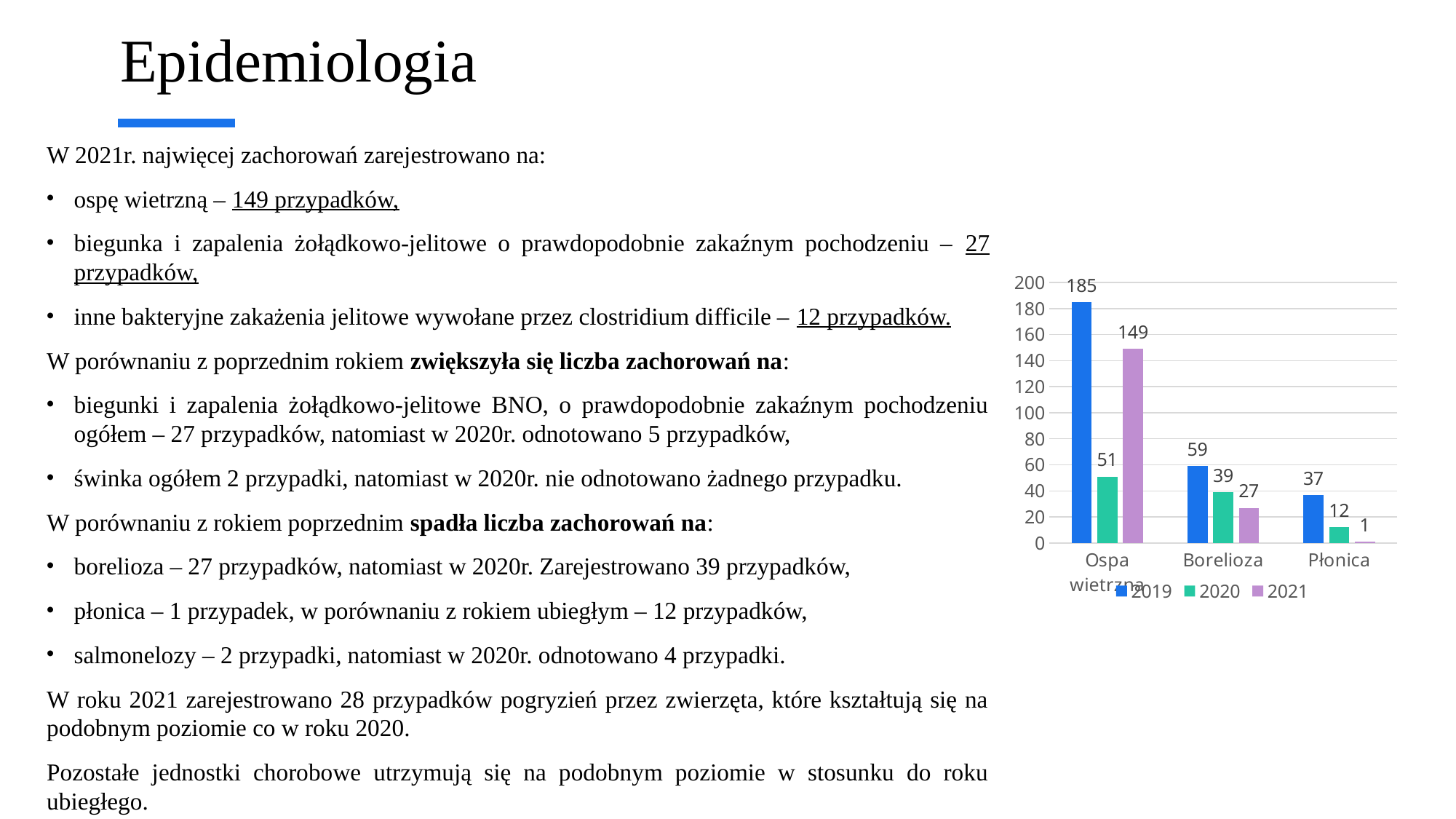
How many series does the legend list? 3 What is the difference between the 2020 and 2021 values for Borelioza? 12 How many categories are shown on the x axis? 3 Which is larger: the 2020 value for Ospa wietrzna or the 2019 value for Borelioza? 2019 value for Borelioza What is the value for Płonica in 2021? 1 What is the value for Borelioza in 2020? 39 Which category has the highest value in 2021? Ospa wietrzna Which category has the lowest value in 2019? Płonica What is the value for Ospa wietrzna in 2019? 185 Do the values for Płonica rise or fall from 2019 to 2021? Fall What kind of chart is shown on the slide? Bar chart What is the difference between the 2019 and 2021 values for Ospa wietrzna? 36